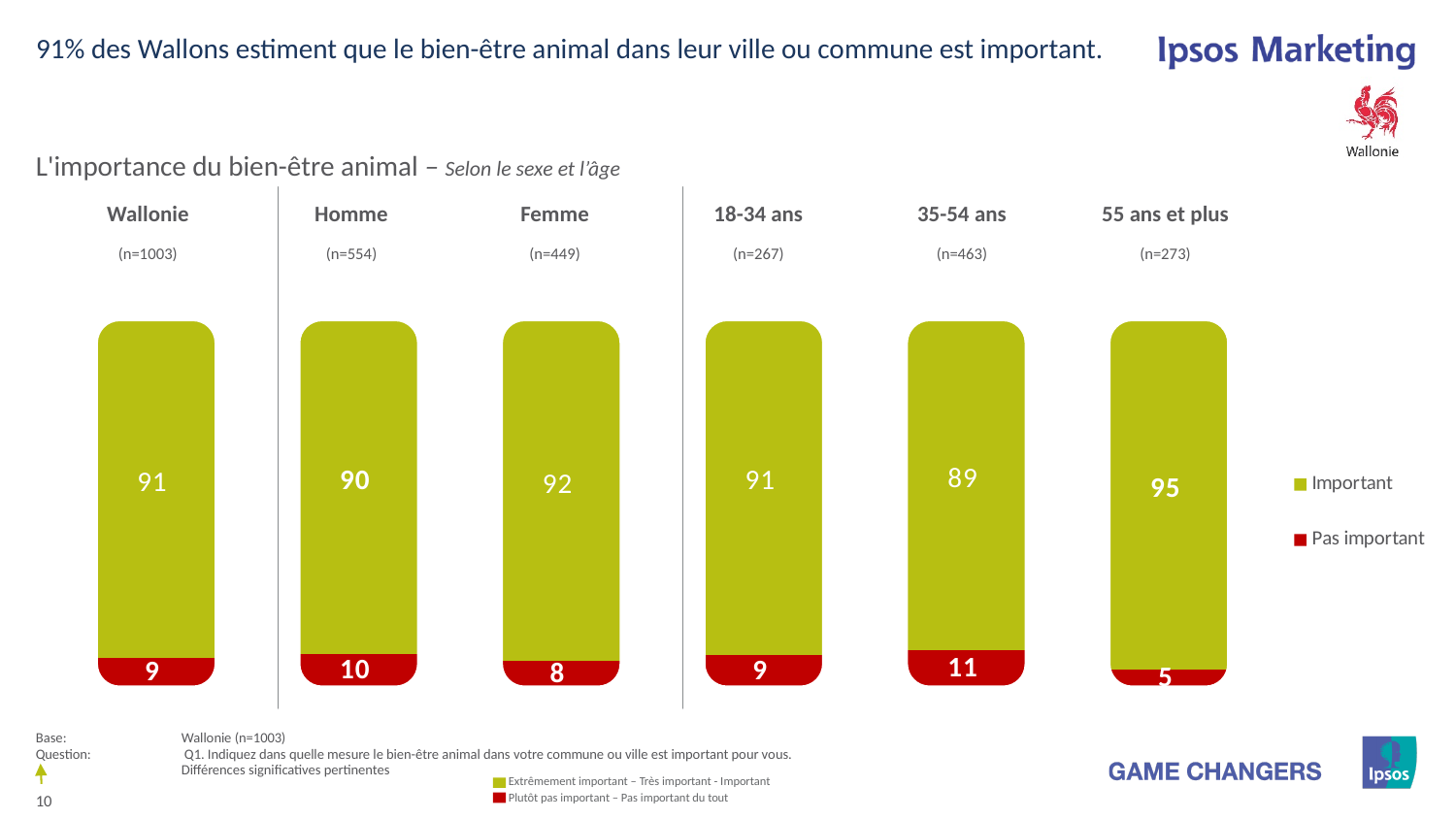
What colour represents the 'Pas important' series in the legend? Red What is the 'Pas important' value for 35-54 ans? 11 What is the difference between the 'Important' values for 55 ans et plus and 35-54 ans? 6 What is the 'Important' value for Wallonie? 91 Which category has the lowest 'Pas important' value? 55 ans et plus What is the total of the stacked bar for 18-34 ans? 100 Which has a larger 'Pas important' value, Homme or Femme? Homme What kind of chart is shown on the slide? Stacked bar chart How many categories are shown in the chart? 6 How many series does the legend list? 2 Which category has the highest 'Important' value? 55 ans et plus What is the 'Important' value for Femme? 92